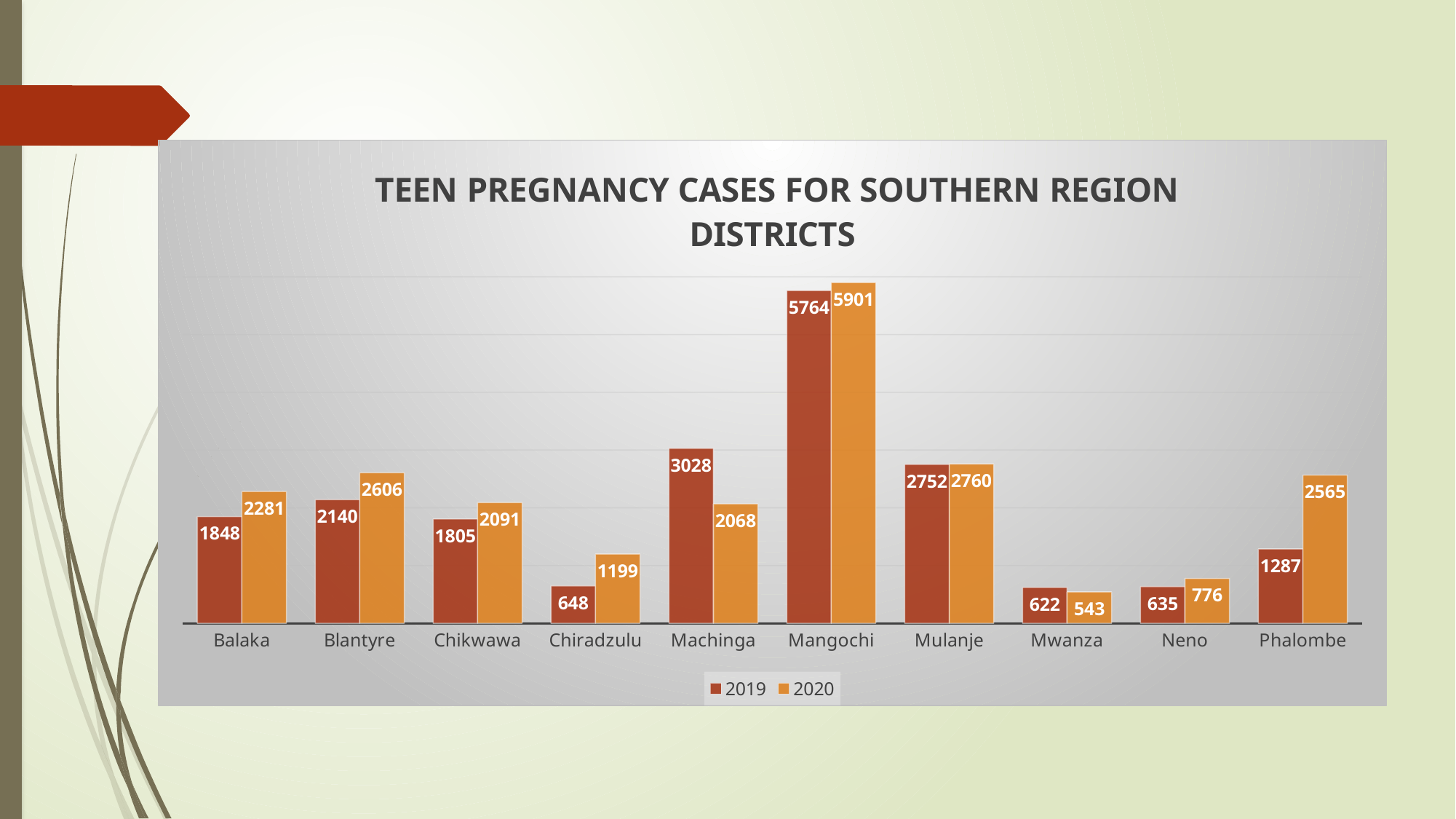
What was the number of teen pregnancy cases in Phalombe in 2019? 1287 Which district had the highest number of teen pregnancy cases in 2019? Mangochi What is the difference between the 2019 and 2020 teen pregnancy cases in Machinga? 960 Which year had more teen pregnancy cases in Mwanza, 2019 or 2020? 2019 What type of chart is shown on the slide? Bar chart How many districts are shown on the chart? 10 Which year had more teen pregnancy cases in Blantyre, 2019 or 2020? 2020 What was the number of teen pregnancy cases in Mangochi in 2020? 5901 What was the number of teen pregnancy cases in Chiradzulu in 2020? 1199 How many series does the legend list? 2 What is the difference between the 2020 and 2019 teen pregnancy cases in Phalombe? 1278 Which district had the lowest number of teen pregnancy cases in 2020? Mwanza